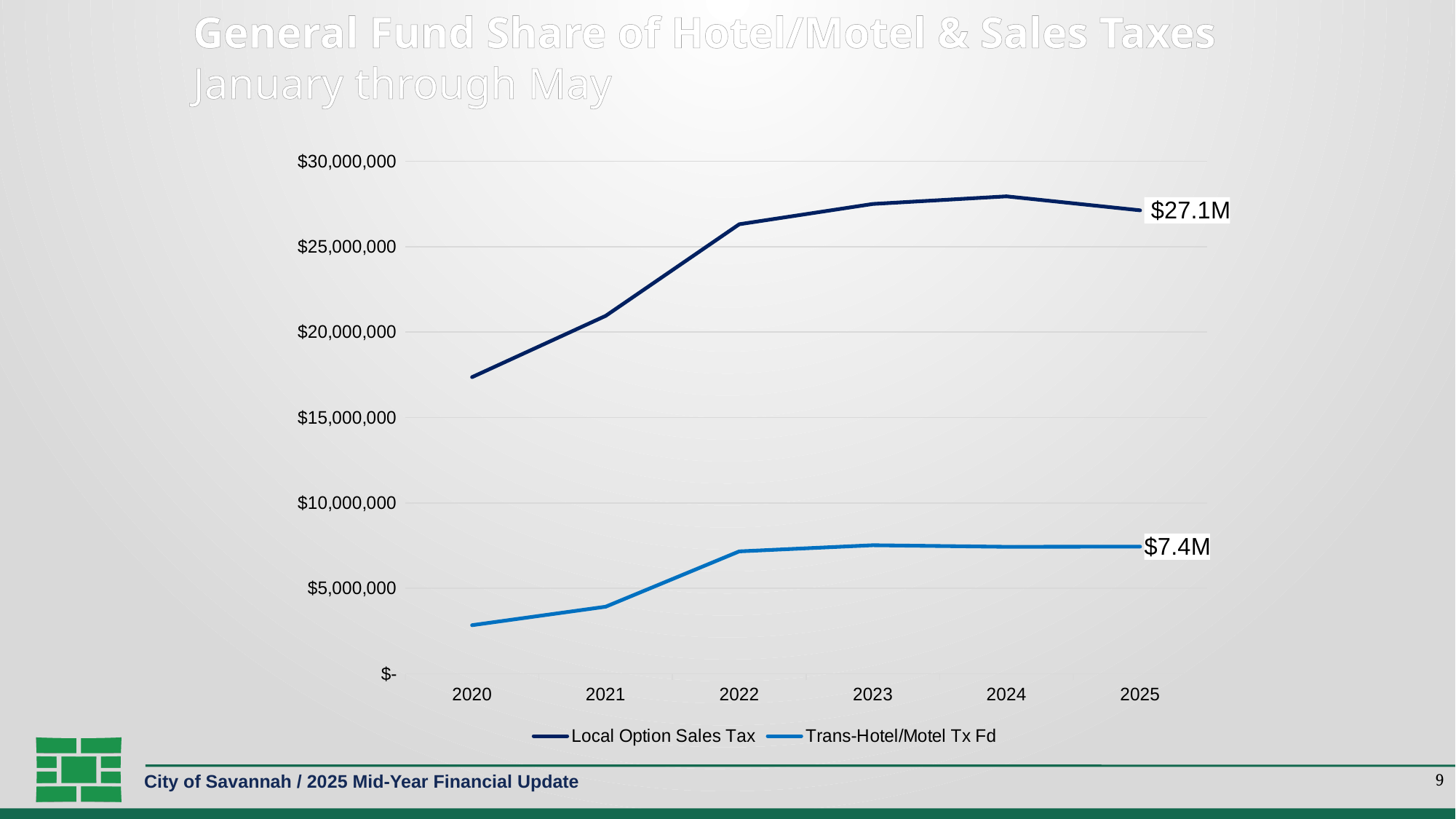
In which year is Local Option Sales Tax highest? 2024 What kind of chart is shown on the slide? Line chart Does Local Option Sales Tax rise or fall from 2020 to 2022? Rise What is the value of Local Option Sales Tax in 2025? $27.1M How many years are plotted on the x axis? 6 Is the value for Trans-Hotel/Motel Tx Fd in 2022 greater or less than $5,000,000? greater What is the value of Trans-Hotel/Motel Tx Fd in 2025? $7.4M How many series does the legend list? 2 Which series has the larger value in 2025, Local Option Sales Tax or Trans-Hotel/Motel Tx Fd? Local Option Sales Tax Is the value for Local Option Sales Tax in 2020 greater or less than $20,000,000? less In which year is Local Option Sales Tax lowest? 2020 In which year is Trans-Hotel/Motel Tx Fd lowest? 2020